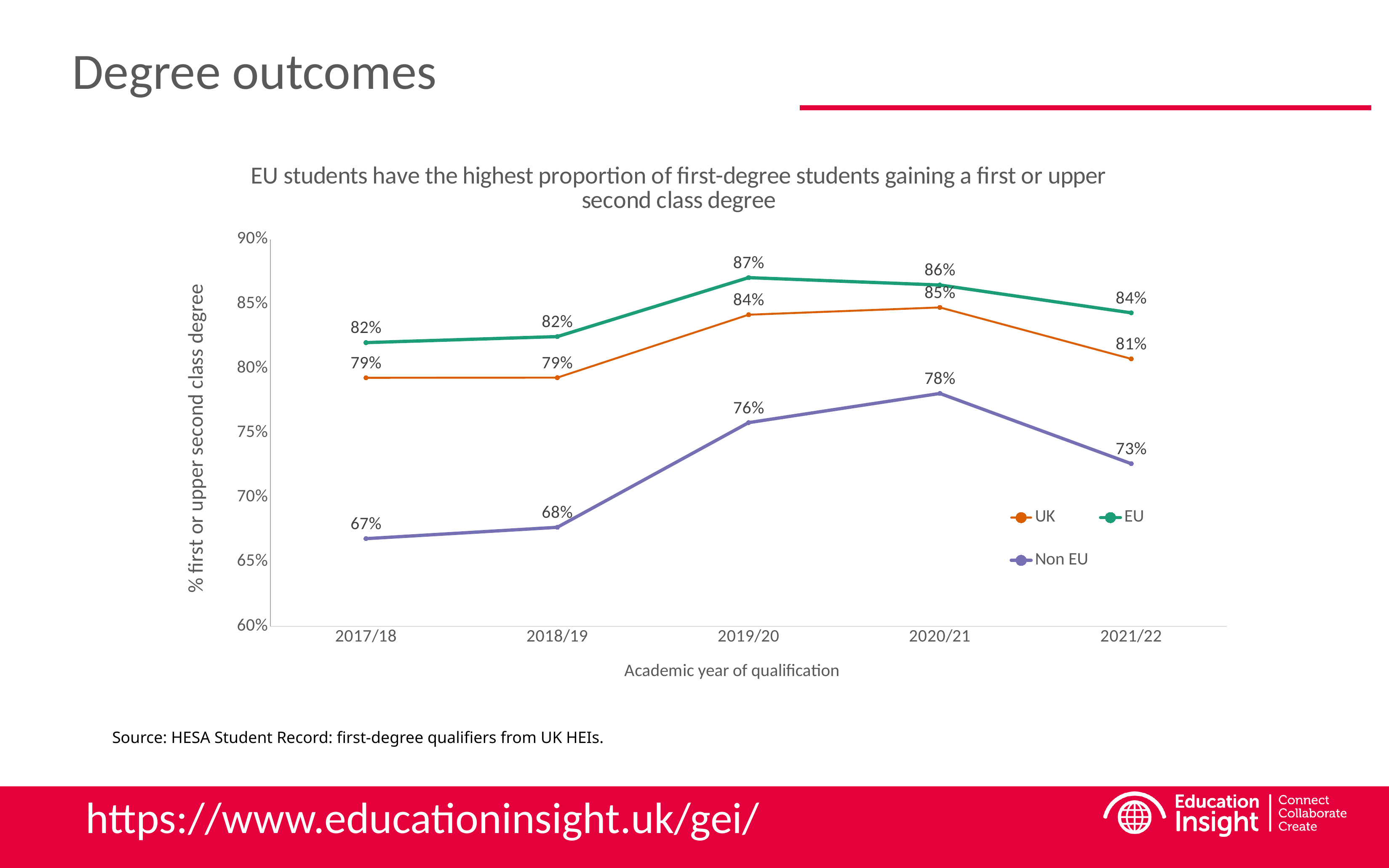
In which academic year is the Non EU value highest? 2020/21 What is the value for Non EU students in 2017/18? 67% How many series does the legend list? 3 Which is larger in 2020/21, the UK value or the Non EU value? UK What kind of chart is shown on the slide? Line chart In which academic year is the UK value lowest? 2017/18 and 2018/19 What is the value for UK students in 2021/22? 81% What is the value for EU students in 2019/20? 87% What is the difference between the EU and Non EU values in 2021/22? 11% Does the Non EU value rise or fall from 2020/21 to 2021/22? Fall How many academic years are plotted on the x axis? 5 What is the label of the x axis? Academic year of qualification